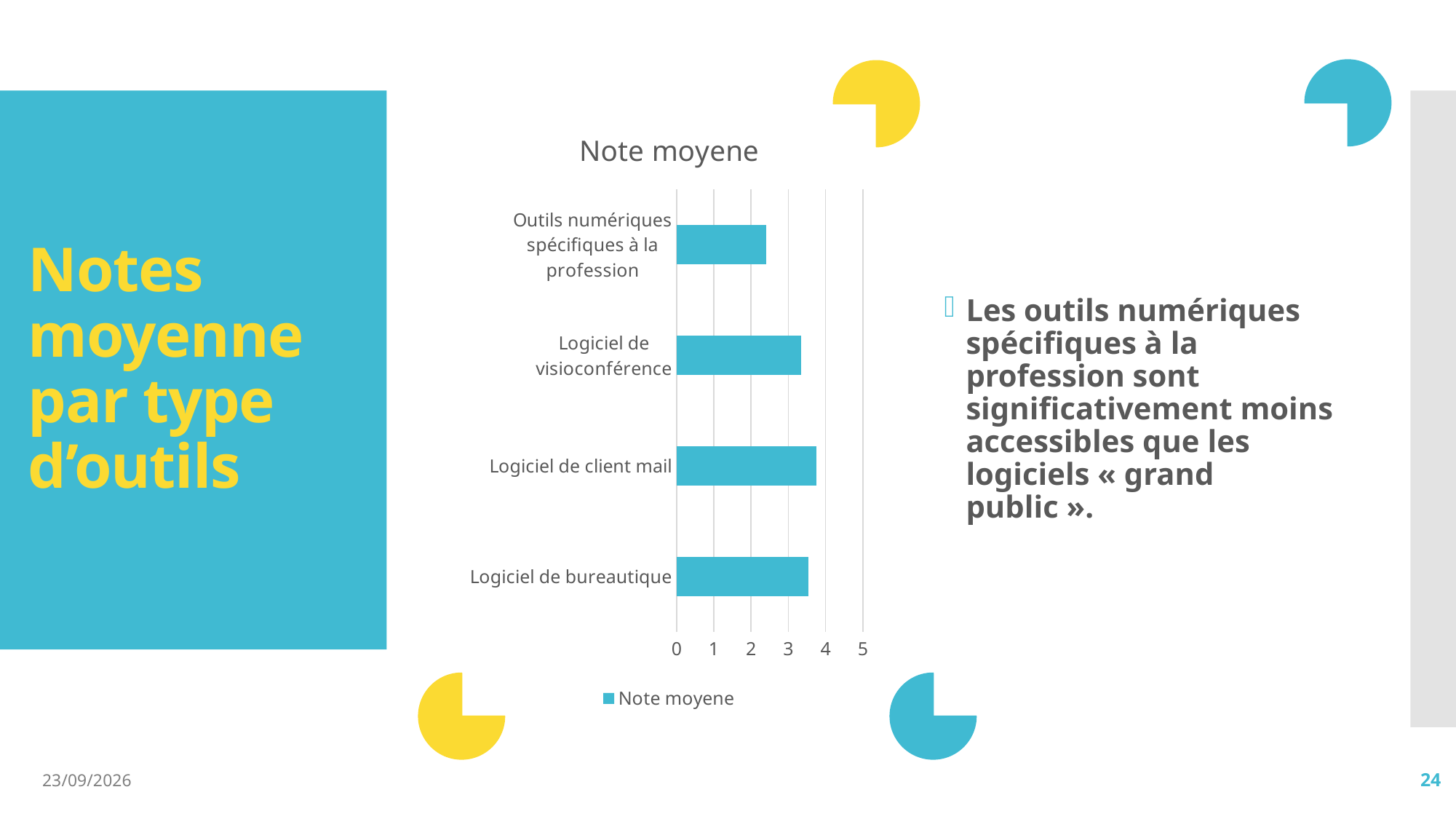
Is the value for Outils numériques spécifiques à la profession greater or less than 3? less Is the value for Logiciel de visioconférence greater or less than 4? less What is the name of the series shown in the chart legend? Note moyene How many series does the chart legend list? 1 Is the value for Outils numériques spécifiques à la profession greater or less than 2? greater Which has a higher value, Logiciel de visioconférence or Outils numériques spécifiques à la profession? Logiciel de visioconférence Which category has the lowest value in the chart? Outils numériques spécifiques à la profession What is the title of the chart? Note moyene How many categories are plotted in the chart? 4 What kind of chart is shown on the slide? Bar chart